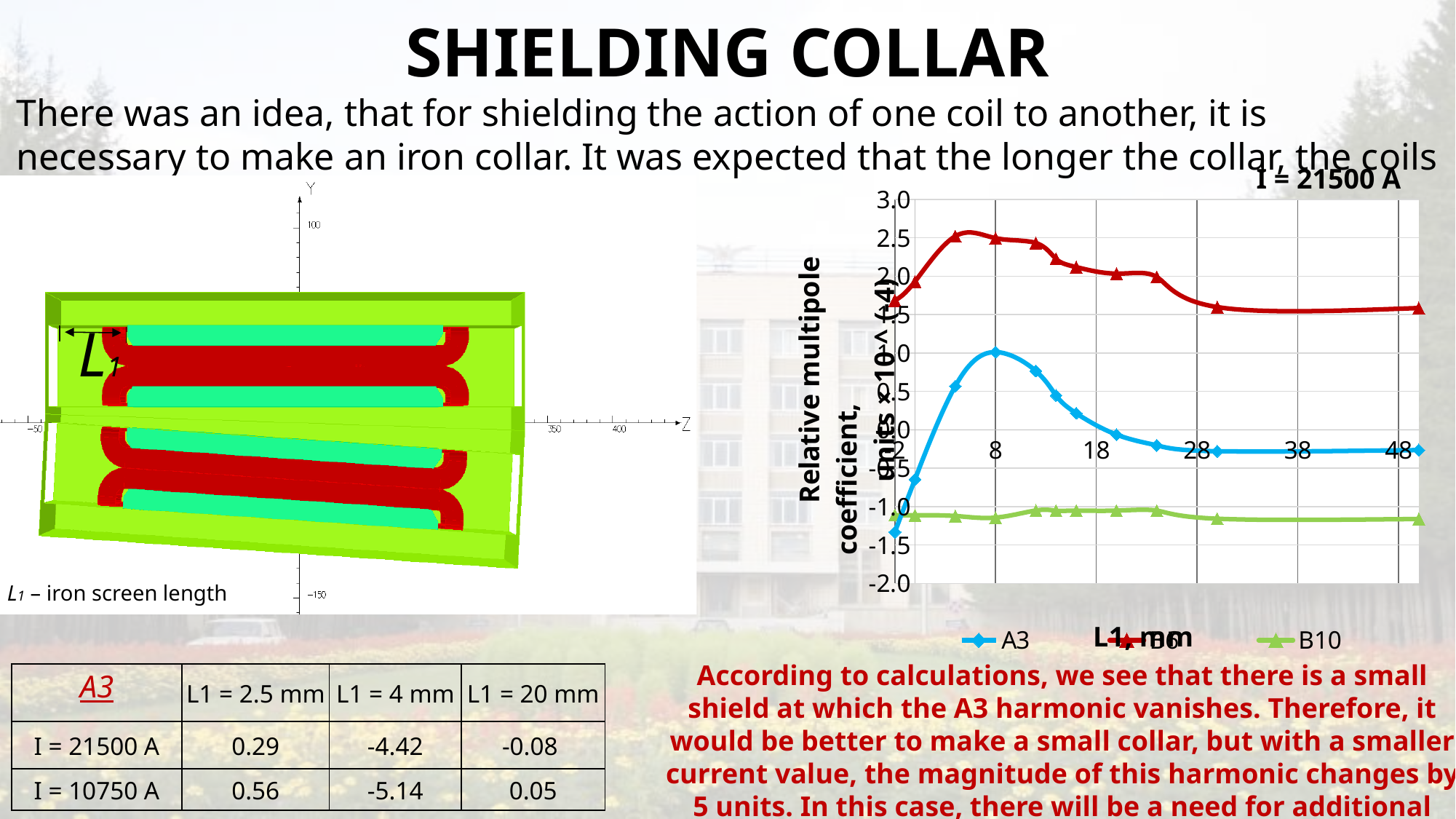
Does the B6 series rise or fall from L1 = 8 mm to L1 = 48 mm? fall Is the value of B10 at L1 = 18 mm greater or less than 0.0? less Is the value of B6 at L1 = 8 mm greater or less than 2.0? greater What is the x-axis title of the chart? L1, mm How many series does the chart legend list? 3 What kind of chart is shown on the slide? line chart Which series has the highest value at L1 = 48 mm? B6 At L1 = 18 mm, which is larger, A3 or B10? A3 Is the value of B6 at L1 = 48 mm greater or less than 1.0? greater What are the series names listed in the chart legend? A3, B6, B10 Which series has the lowest value at L1 = 28 mm? B10